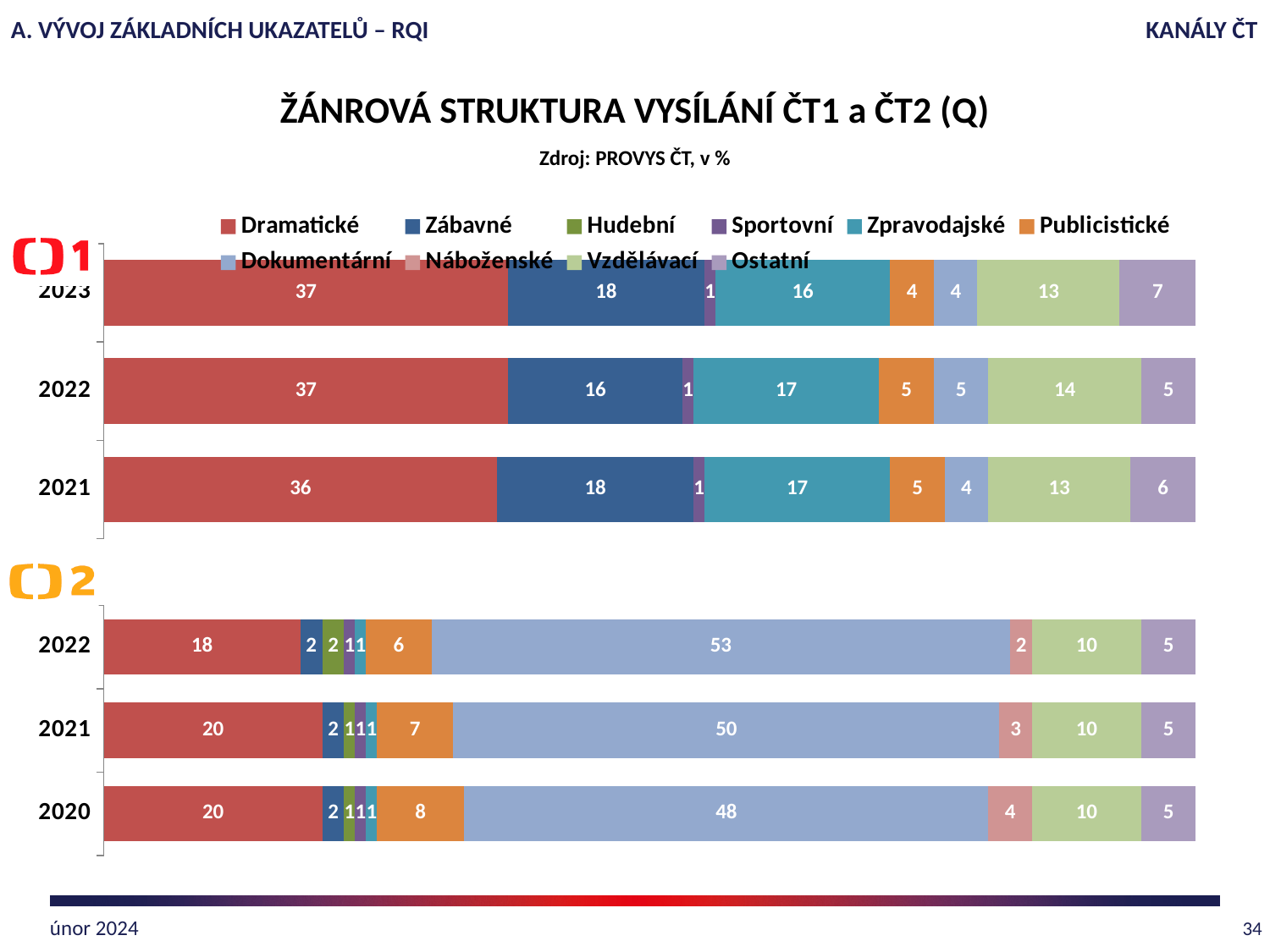
What kind of chart is used for ČT1 and ČT2? Stacked bar chart In the ČT2 chart, what is the value for Dokumentární in 2022? 53 In the ČT2 chart, does the Dokumentární value rise or fall from 2020 to 2022? Rise In the ČT2 chart, which genre has the largest share in 2021? Dokumentární How many series does the legend list? 10 In the ČT2 chart, what is the value for Publicistické in 2020? 8 In the ČT2 chart, what is the difference between the Dokumentární value in 2022 and in 2020? 5 In the ČT1 chart, which is larger in 2021: Zábavné or Zpravodajské? Zábavné In the ČT1 chart, what is the value for Vzdělávací in 2022? 14 In the ČT1 chart, which genre has the largest share in 2022? Dramatické In the ČT1 chart, what is the value for Dramatické in 2023? 37 In the ČT1 chart, what is the value for Ostatní in 2023? 7